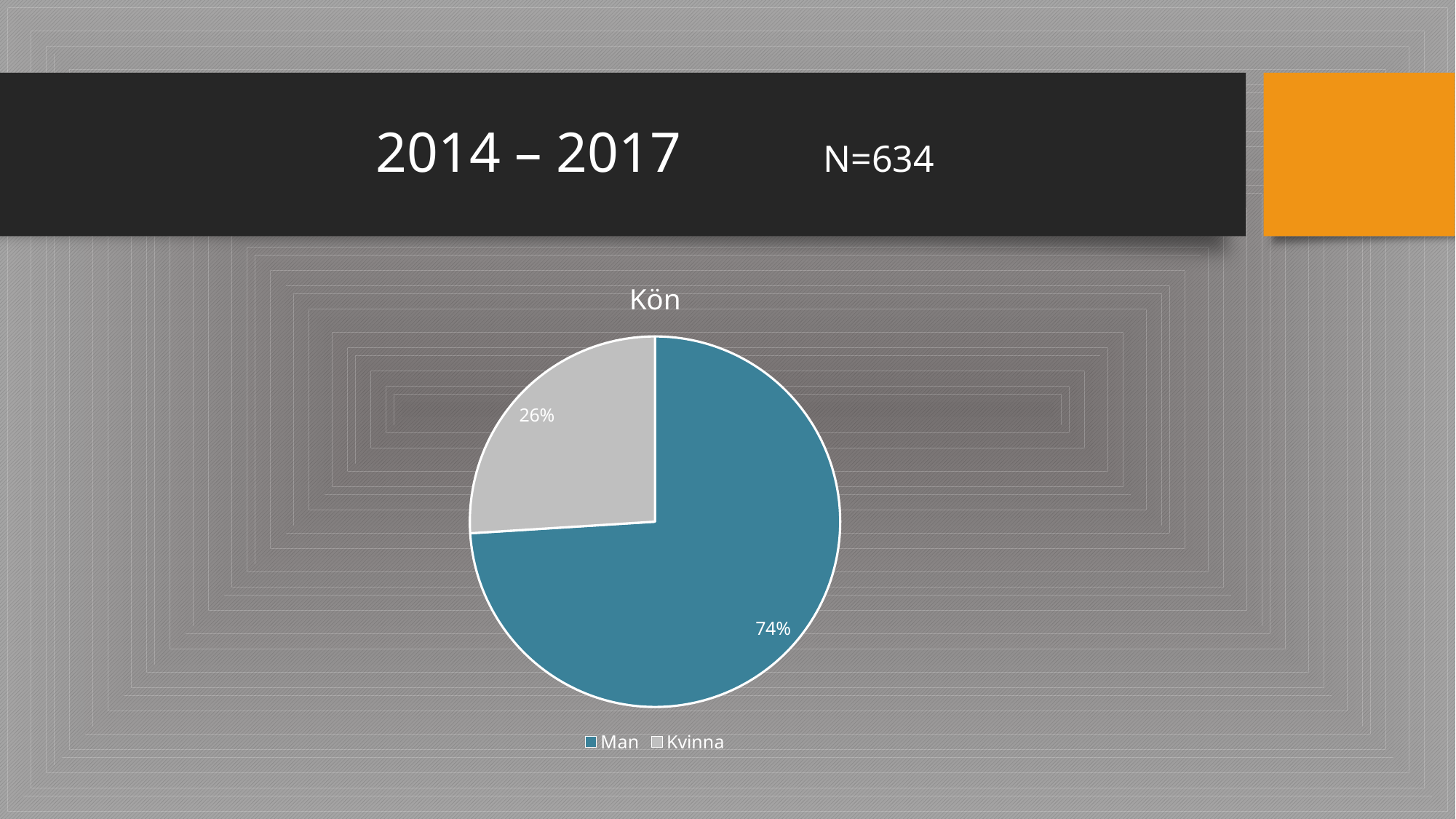
What is the title of the chart? Kön Which category has the largest slice of the pie? Man What kind of chart is shown on the slide? pie chart Which category has the smallest slice of the pie? Kvinna How many categories does the pie chart have? 2 What colour is the Kvinna slice? grey What share of the pie does Kvinna represent? 26% How many entries does the legend list? 2 What share of the pie does Man represent? 74% Which is larger, the Man slice or the Kvinna slice? Man What is the difference in percentage points between the Man and Kvinna slices? 48